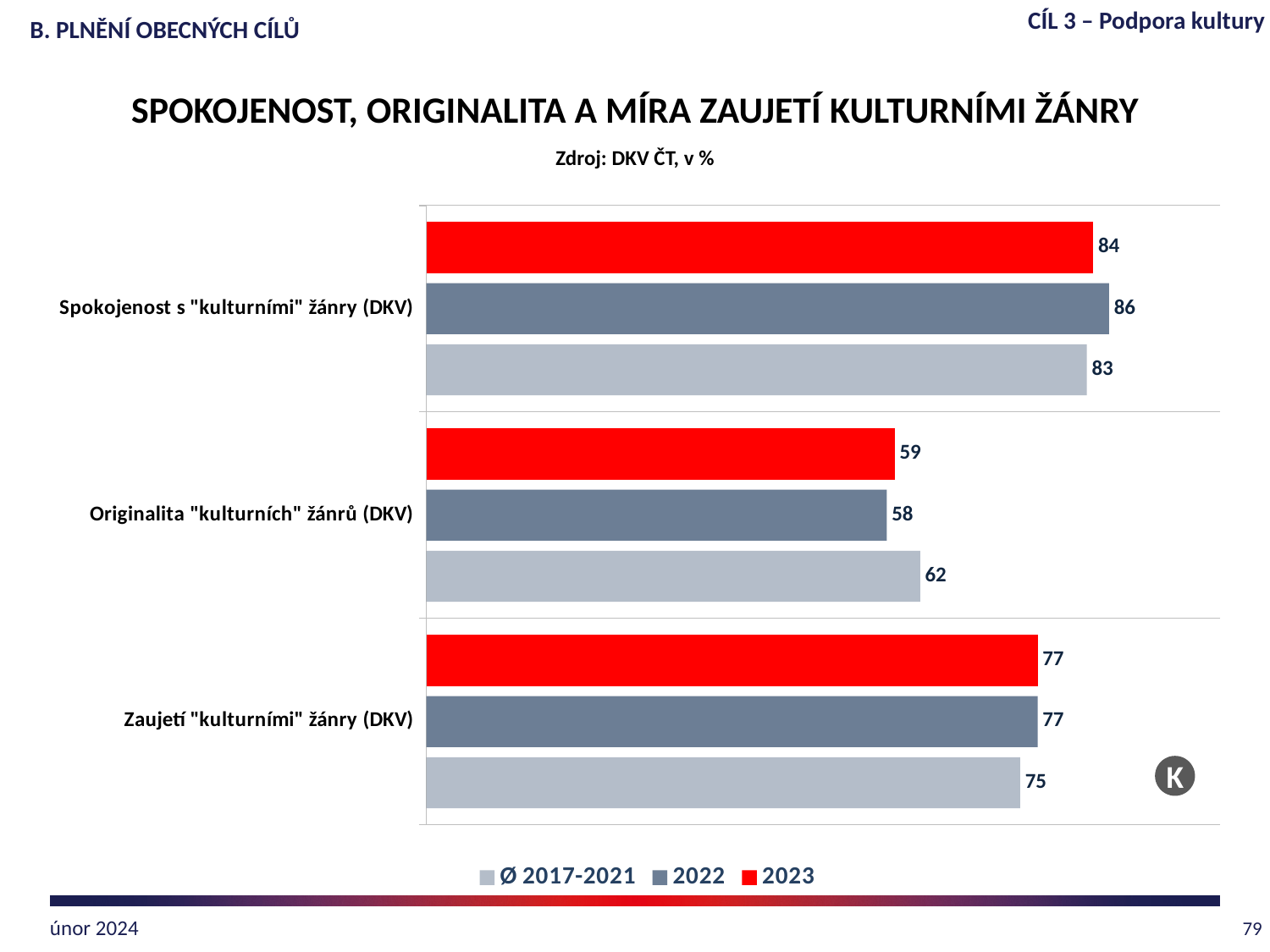
What kind of chart is shown on the slide? bar chart Which colour represents the 2023 series in the legend? red What is the 2022 value for Originalita "kulturních" žánrů (DKV)? 58 What is the 2023 value for Spokojenost s "kulturními" žánry (DKV)? 84 What is the Ø 2017-2021 value for Zaujetí "kulturními" žánry (DKV)? 75 Which category has the highest 2023 value? Spokojenost s "kulturními" žánry (DKV) What is the difference between the 2022 and 2023 values for Spokojenost s "kulturními" žánry (DKV)? 2 What is the difference between the Ø 2017-2021 and 2023 values for Zaujetí "kulturními" žánry (DKV)? 2 Which category has the lowest Ø 2017-2021 value? Originalita "kulturních" žánrů (DKV) For Originalita "kulturních" žánrů (DKV), which is larger: the Ø 2017-2021 value or the 2023 value? Ø 2017-2021 How many categories are shown on the chart? 3 How many series does the legend list? 3